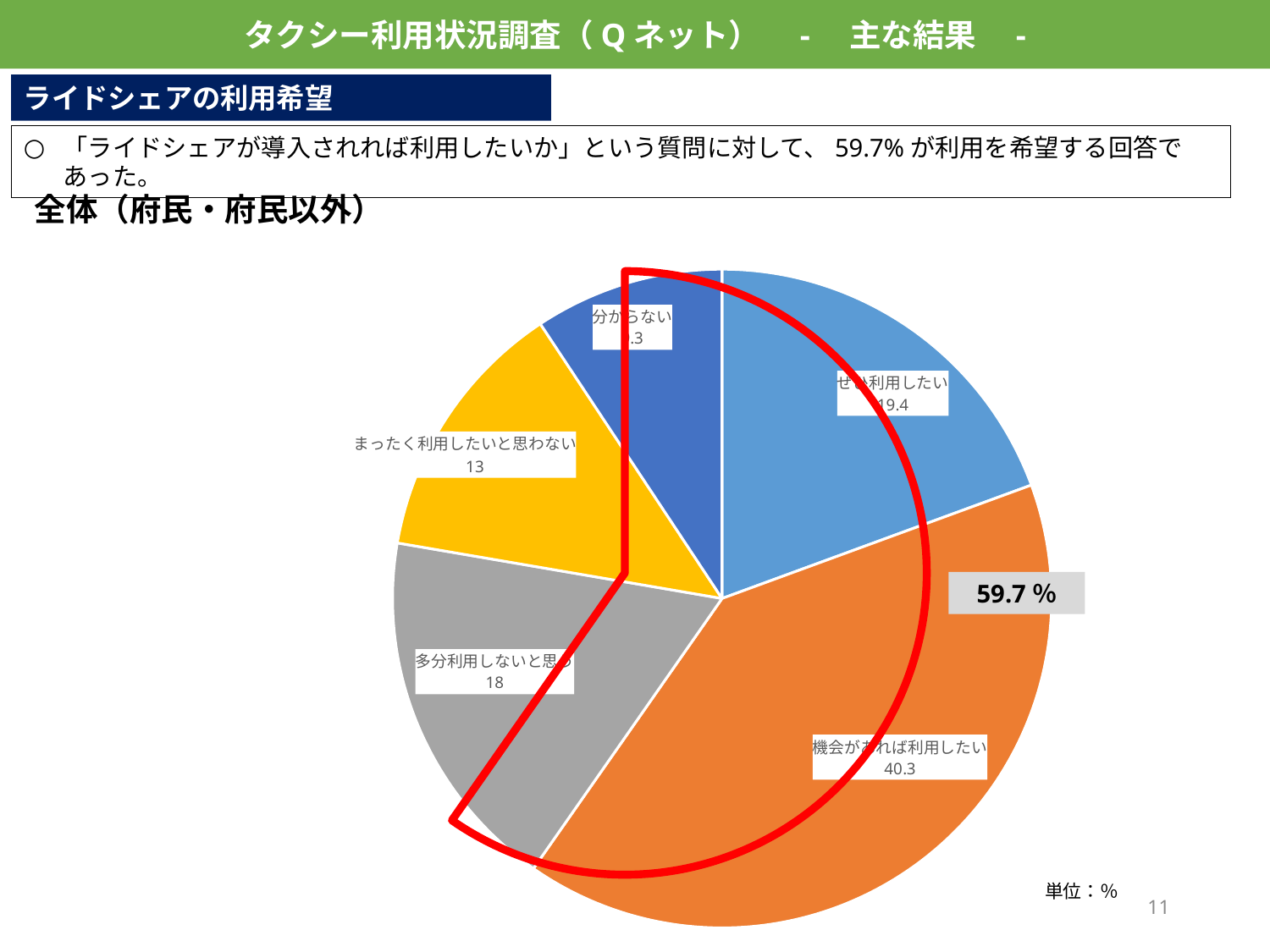
What combined percentage is highlighted by the red outline on the pie chart? 59.7% Which is larger, 機会があれば利用したい or ぜひ利用したい? 機会があれば利用したい What is the value for まったく利用したいと思わない? 13 Which category has the largest slice of the pie? 機会があれば利用したい What is the value for 機会があれば利用したい? 40.3 What is the difference between 機会があれば利用したい and 多分利用しないと思う? 22.3 What is the difference between 多分利用しないと思う and まったく利用したいと思わない? 5 Which category has the smallest slice of the pie? 分からない What is the value for 多分利用しないと思う? 18 Which is larger, 多分利用しないと思う or まったく利用したいと思わない? 多分利用しないと思う What kind of chart is shown on the slide? pie chart How many slices does the pie chart have? 5